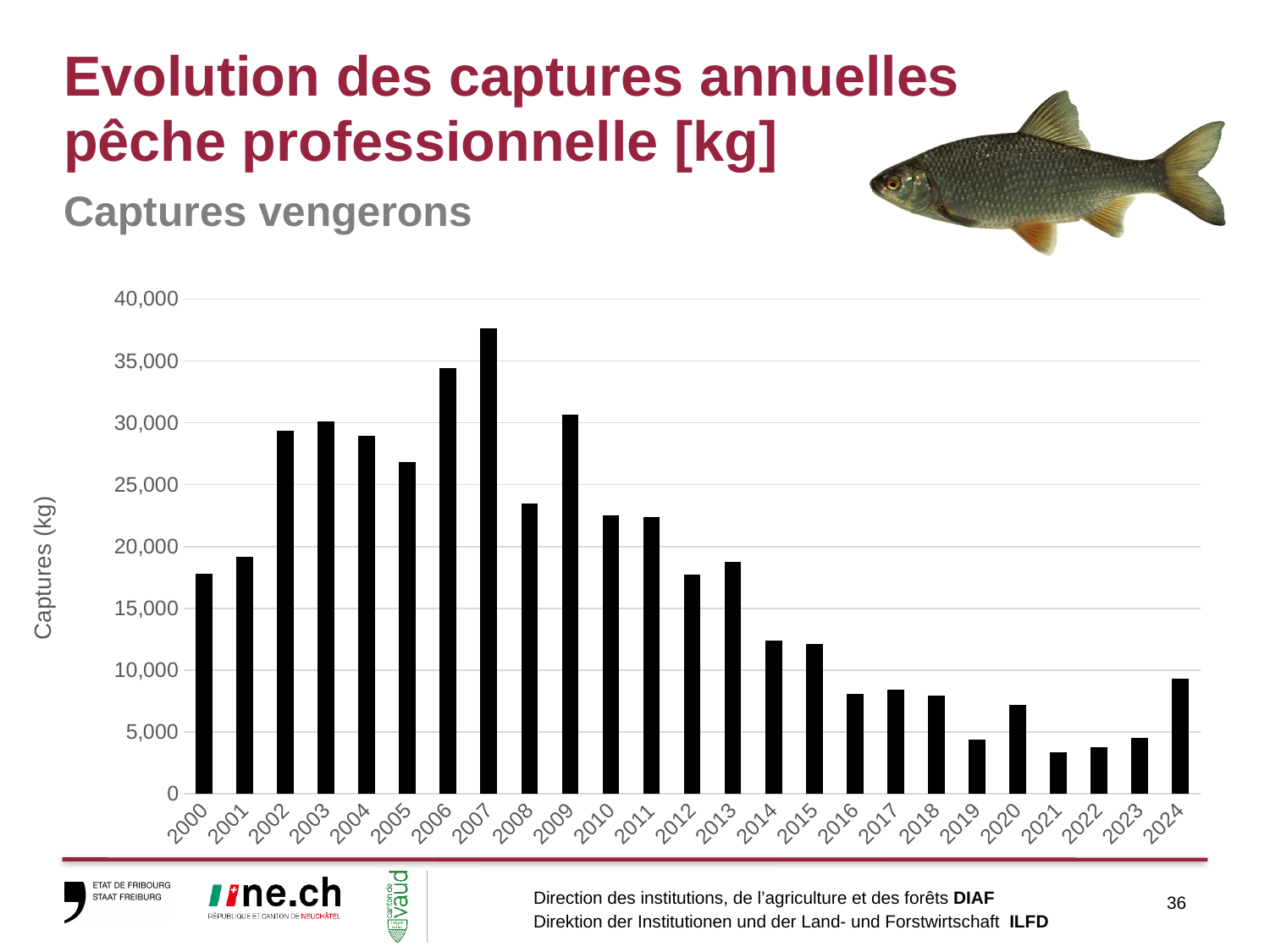
Is the value for 2008 greater or less than 25,000? less Do the catches generally rise or fall from 2007 to 2021? fall Is the value for 2014 greater or less than 10,000? greater Is the value for 2000 greater or less than 15,000? greater How many years (bars) are plotted in the chart? 25 What is the label on the vertical axis of the chart? Captures (kg) Which year has the larger catch, 2019 or 2020? 2020 Which year has the highest catch in the chart? 2007 What kind of chart is shown on the slide? bar chart Which year has the larger catch, 2006 or 2007? 2007